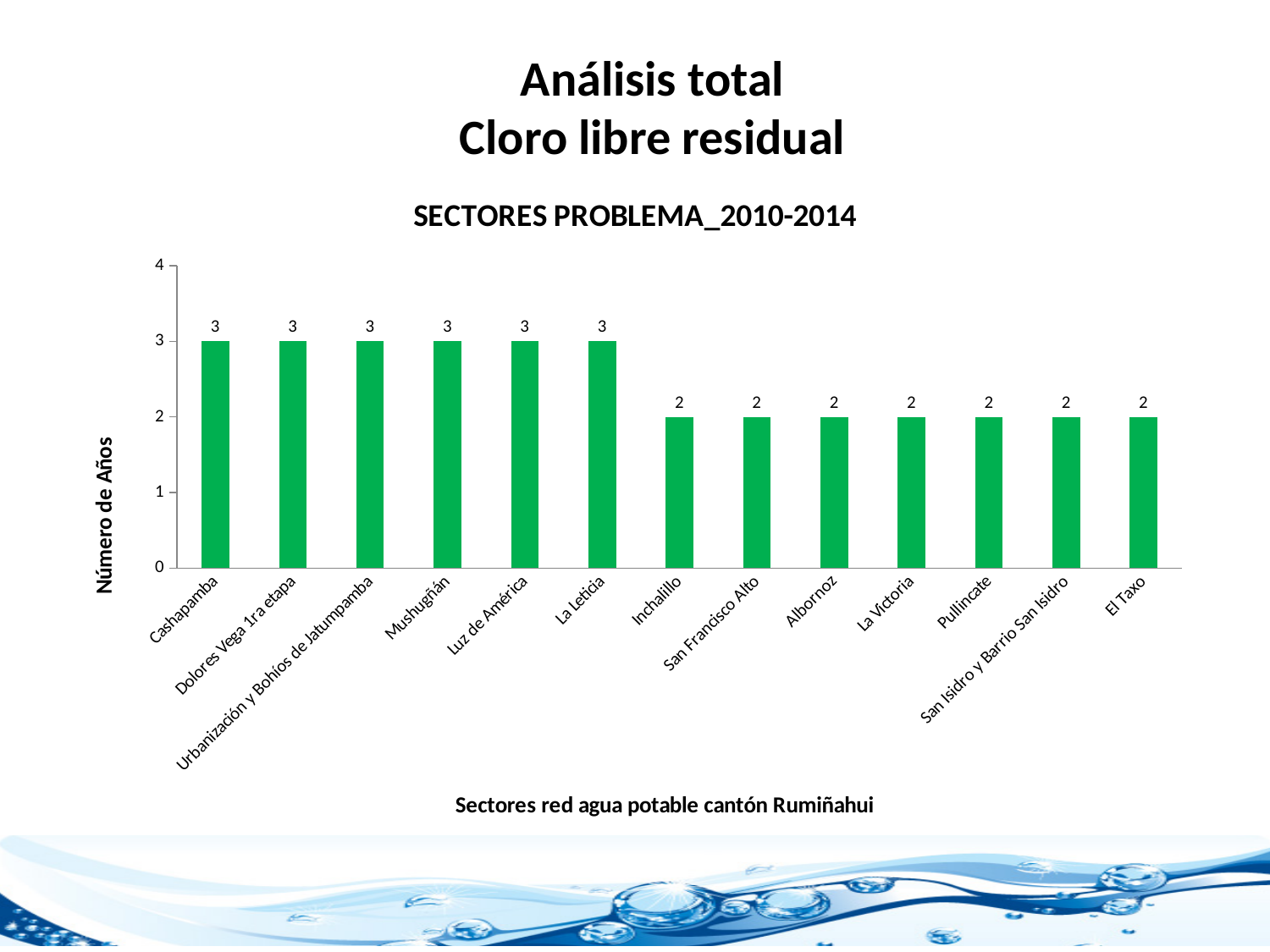
What is the title of the chart? SECTORES PROBLEMA_2010-2014 How many categories have a value of 3? 6 What is the value for El Taxo? 2 What is the label of the y axis? Número de Años How many categories are shown on the x axis? 13 What is the value for La Leticia? 3 What is the value for Cashapamba? 3 What is the value for Inchalillo? 2 Which is larger, the value for Luz de América or the value for Pullincate? Luz de América Do the values rise or fall from left to right along the x axis? Fall What kind of chart is shown on the slide? Bar chart What is the difference between the values for Mushuñán and Albornoz? 1